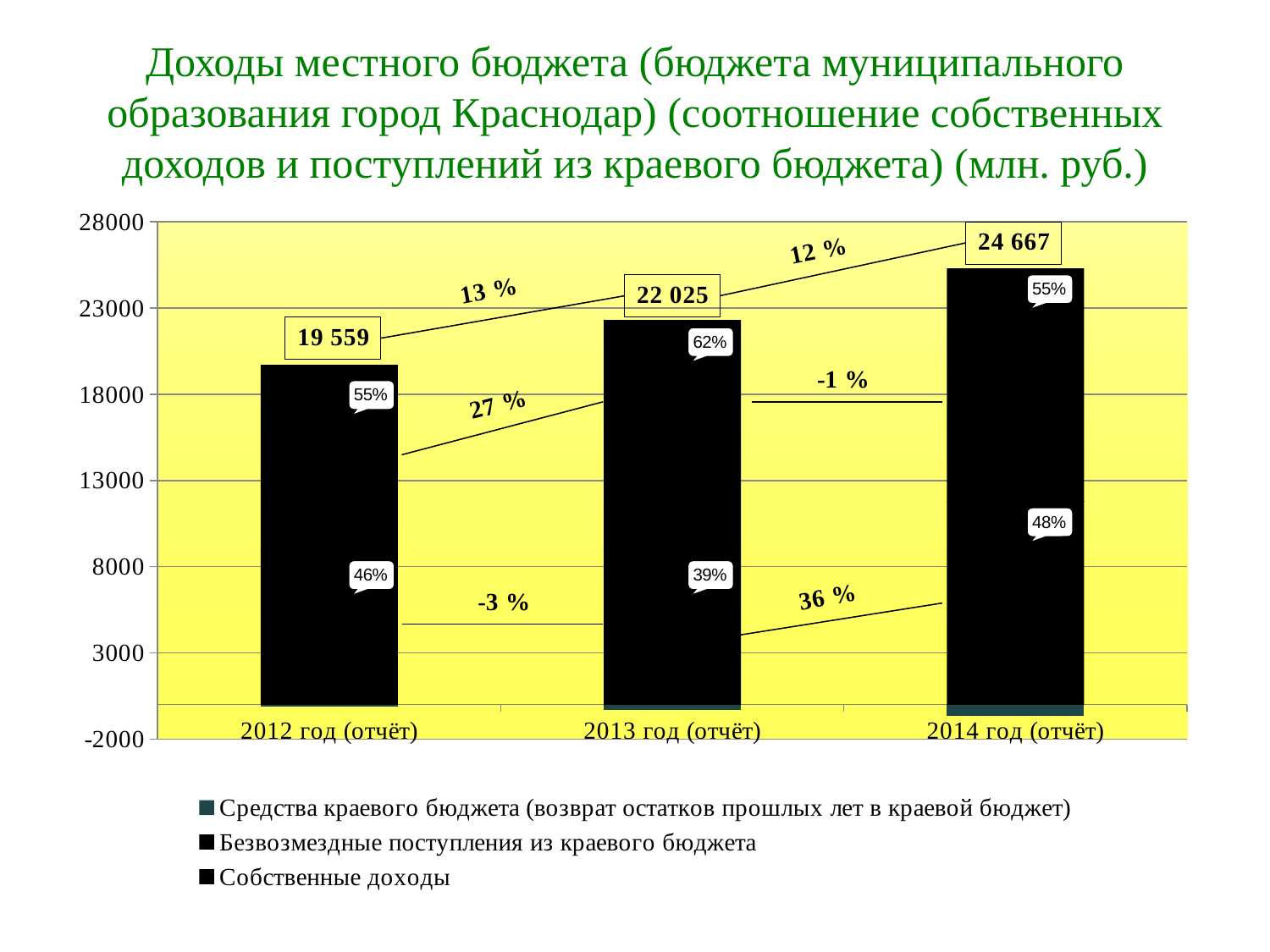
What kind of chart is shown on the slide? Stacked bar chart Do the total values rise or fall from 2012 to 2014? Rise Which year has the lowest total value? 2012 год (отчёт) How many series does the legend list? 3 What is the difference between the total for 2013 год (отчёт) and the total for 2012 год (отчёт)? 2 466 Which is larger, the total for 2013 год (отчёт) or the total for 2014 год (отчёт)? 2014 год (отчёт) What is the difference between the total for 2014 год (отчёт) and the total for 2012 год (отчёт)? 5 108 What is the total value shown for 2014 год (отчёт)? 24 667 What is the total value shown for 2012 год (отчёт)? 19 559 How many years (categories) are shown on the x axis? 3 Which year has the highest total value? 2014 год (отчёт) What is the total value shown for 2013 год (отчёт)? 22 025